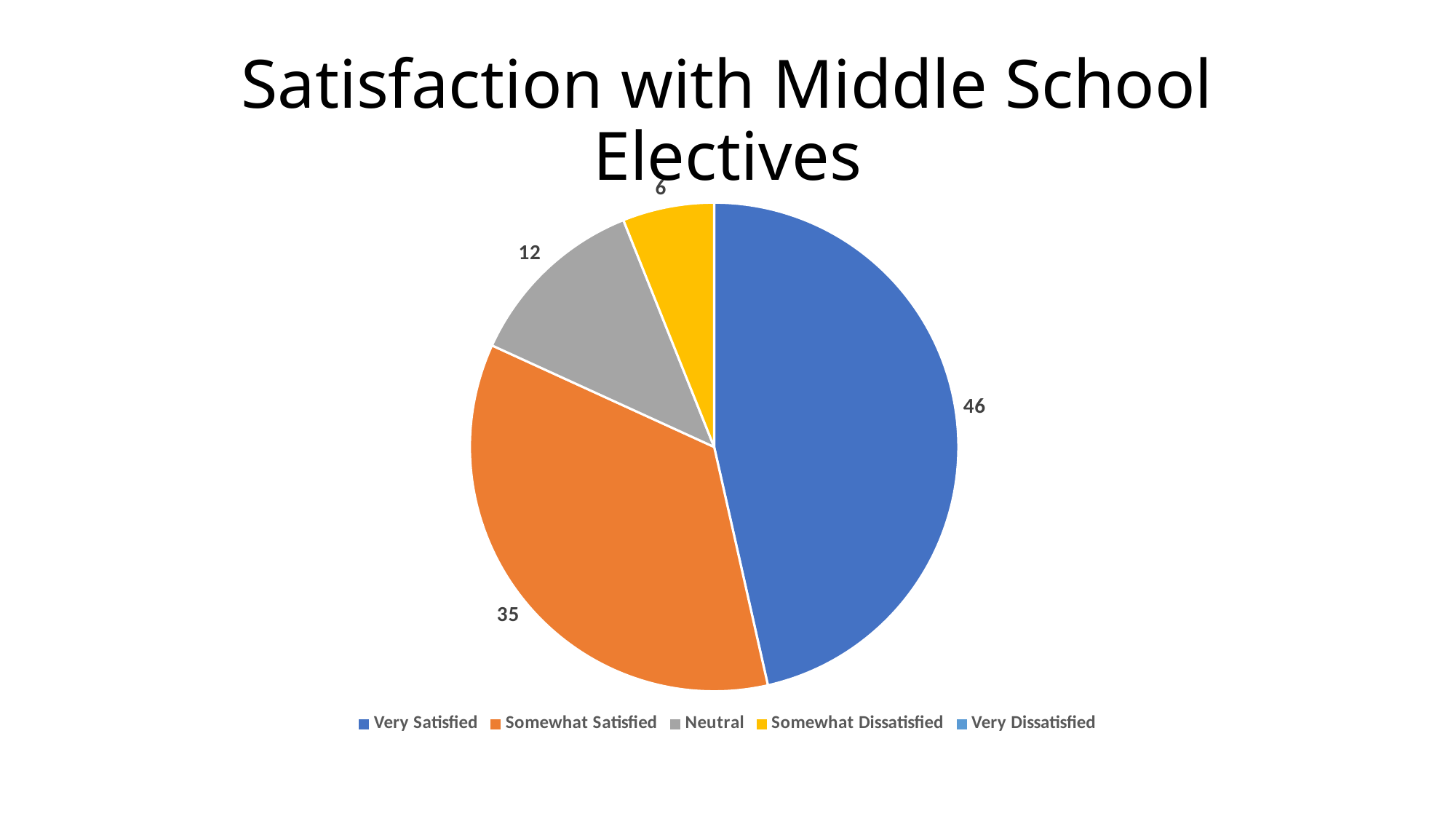
Which is larger, Neutral or Somewhat Satisfied? Somewhat Satisfied What is the value for Very Satisfied? 46 What is the difference between the Neutral and Somewhat Dissatisfied values? 6 Which labelled slice is the smallest? Somewhat Dissatisfied Which category has the largest slice? Very Satisfied What is the value for Somewhat Satisfied? 35 What is the value for Neutral? 12 What is the difference between the Very Satisfied and Somewhat Satisfied values? 11 What type of chart is shown on the slide? pie chart What is the title of the chart? Satisfaction with Middle School Electives How many entries does the legend list? 5 What is the value for Somewhat Dissatisfied? 6